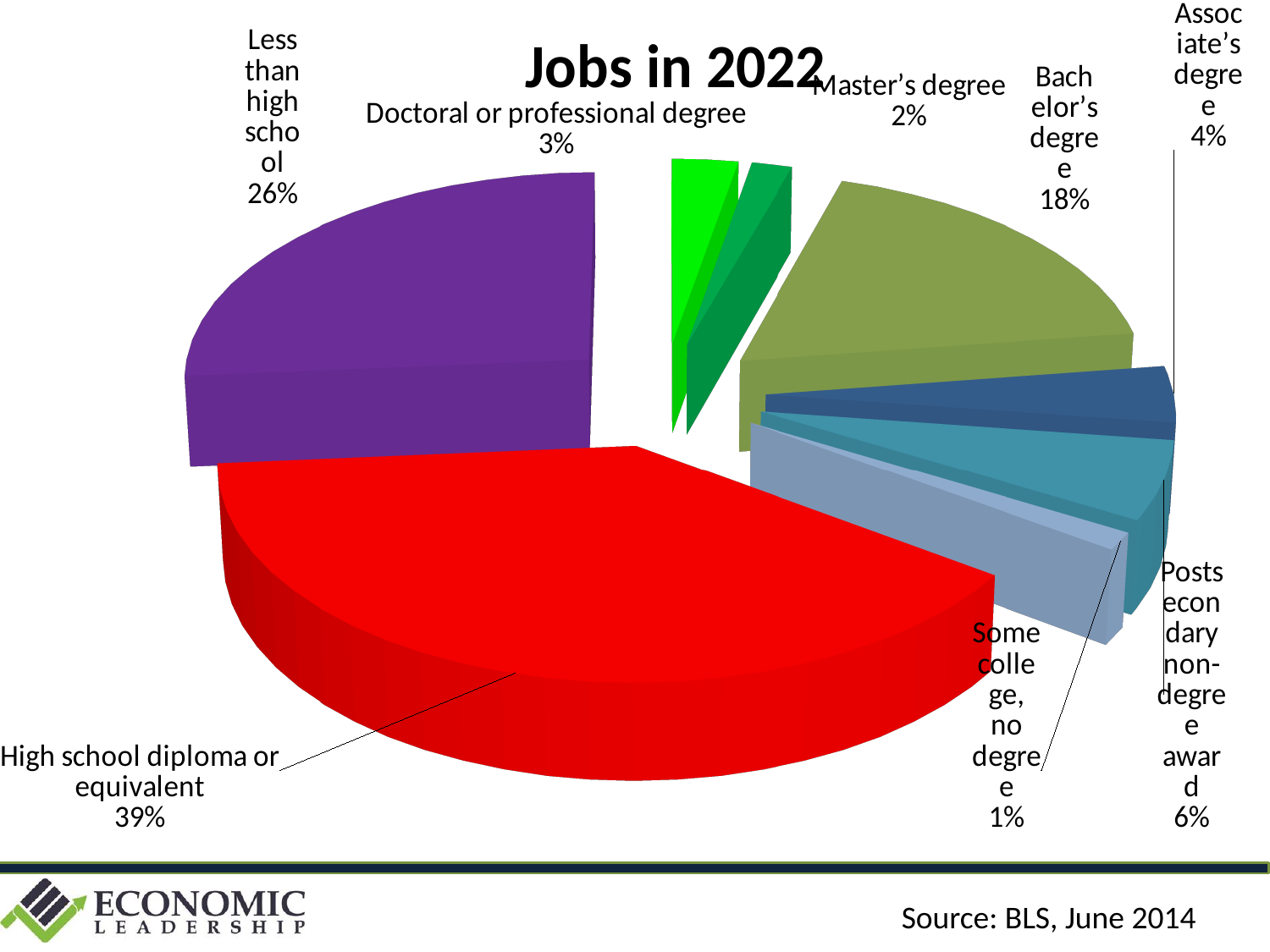
What share of jobs in 2022 is shown for Bachelor's degree? 18% Which category has the smallest share of the pie? Some college, no degree What share of jobs in 2022 is shown for Less than high school? 26% Which is larger, the share for Associate's degree or the share for Master's degree? Associate's degree Which category has the largest share of the pie? High school diploma or equivalent What is the difference in percentage points between High school diploma or equivalent and Bachelor's degree? 21 What share of jobs in 2022 is shown for High school diploma or equivalent? 39% What kind of chart is shown on the slide? pie chart What share of jobs in 2022 is shown for Doctoral or professional degree? 3% What share of jobs in 2022 is shown for Postsecondary non-degree award? 6% What is the title of the chart? Jobs in 2022 How many categories are shown in the pie chart? 8